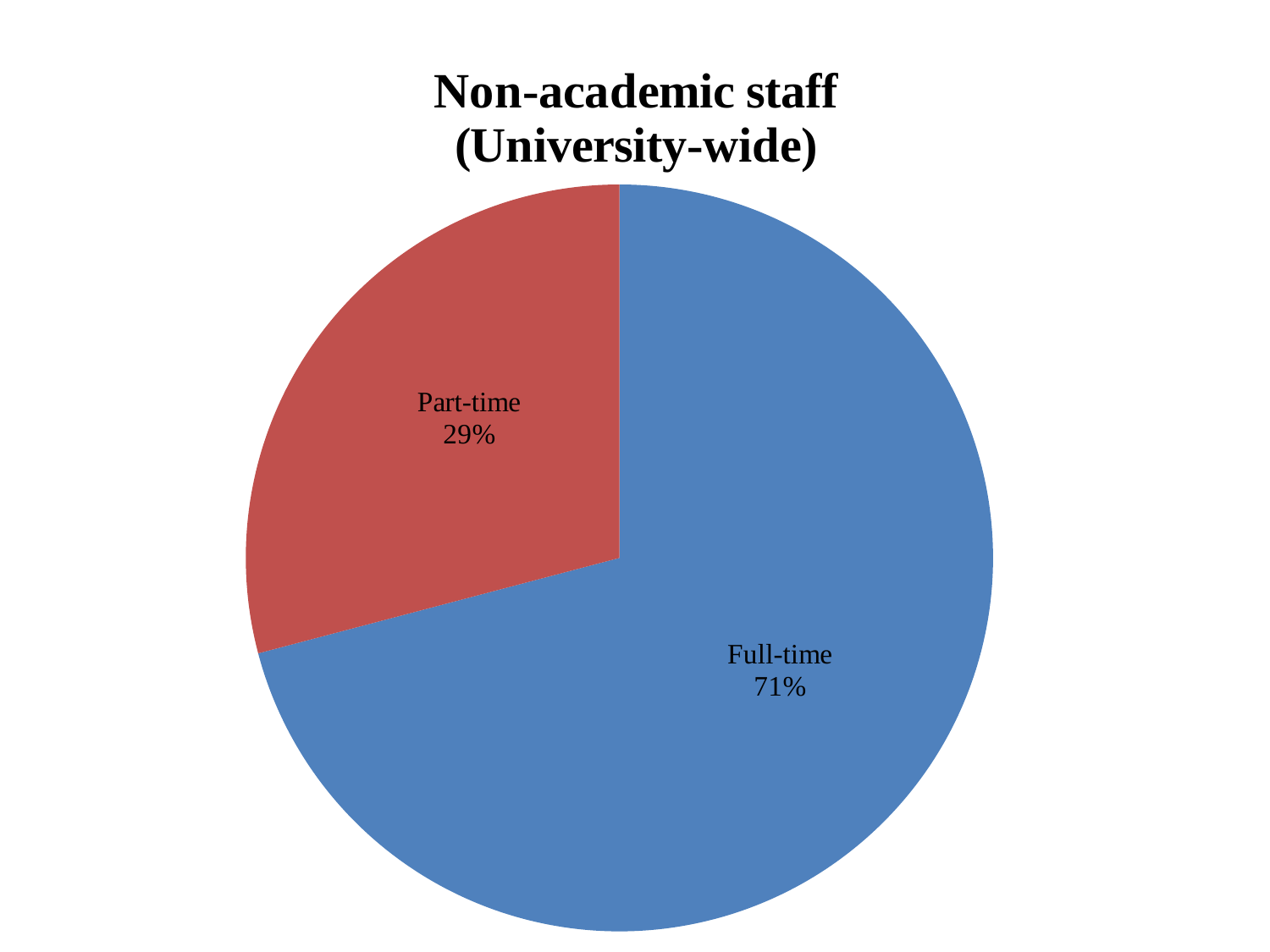
What share of non-academic staff is Part-time? 29% What share of non-academic staff is Full-time? 71% What is the title of the chart? Non-academic staff (University-wide) What colour is the Part-time slice? Red Which category has the smallest slice of the pie? Part-time What is the difference in percentage points between the Full-time and Part-time shares? 42 How many slices does the pie chart have? 2 What kind of chart is shown on the slide? Pie chart Which category has the largest slice of the pie? Full-time Which is larger, the Full-time share or the Part-time share? Full-time